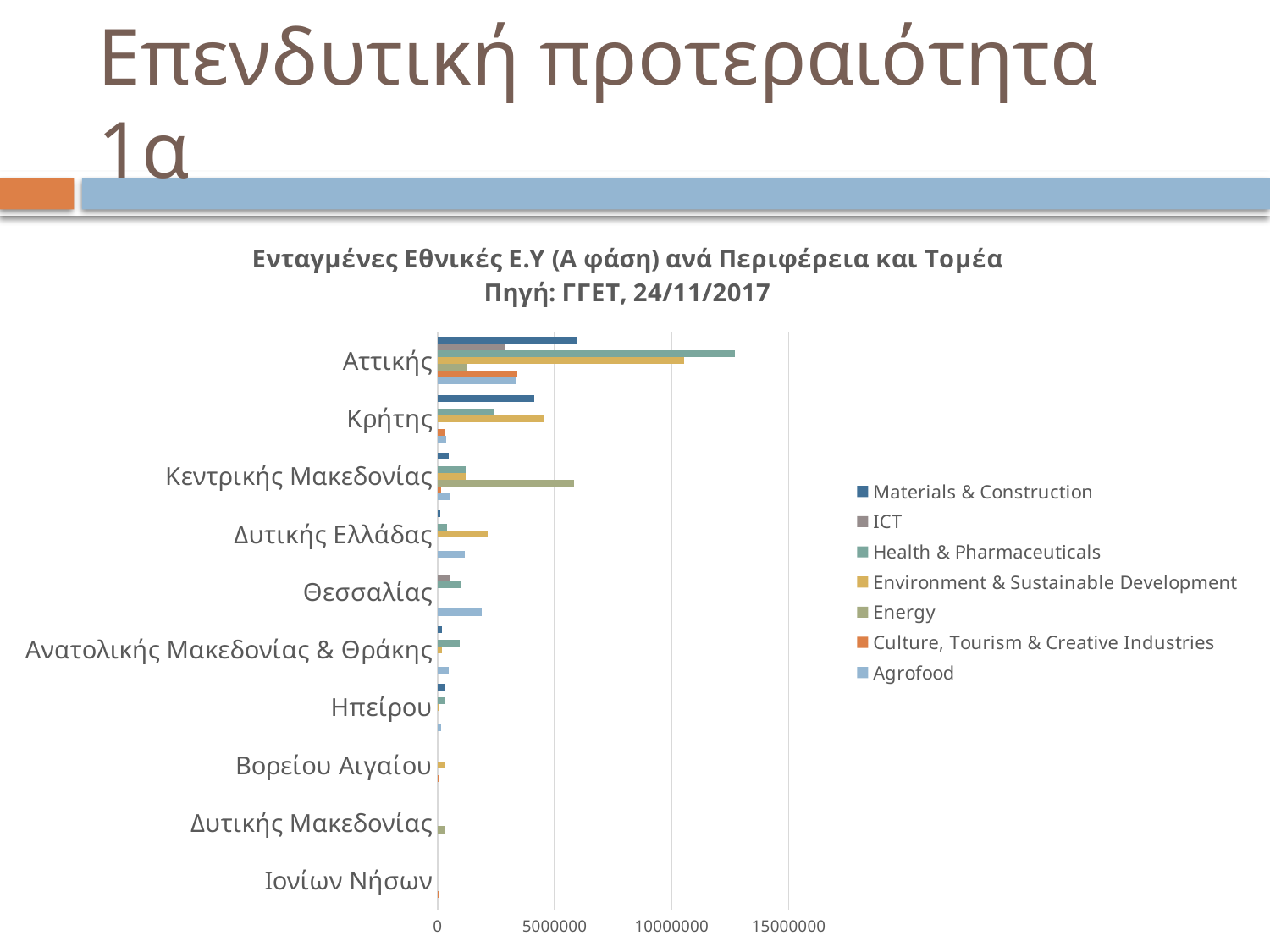
Which region has the smallest bars overall in the chart? Ιονίων Νήσων How many regions (categories) are listed on the vertical axis of the chart? 10 What kind of chart is shown on the slide? bar chart For Κεντρικής Μακεδονίας, which is larger: the Energy value or the Health & Pharmaceuticals value? Energy What is the title of the chart? Ενταγμένες Εθνικές Ε.Υ (Α φάση) ανά Περιφέρεια και Τομέα Πηγή: ΓΓΕΤ, 24/11/2017 How many series does the chart legend list? 7 Is the ICT value for Αττικής greater or less than 5000000? less Is the Agrofood value for Θεσσαλίας greater or less than 5000000? less For Κρήτης, which is larger: the Environment & Sustainable Development value or the Health & Pharmaceuticals value? Environment & Sustainable Development Is the Health & Pharmaceuticals value for Αττικής greater or less than 10000000? greater Which series has the longest bar for Θεσσαλίας? Agrofood Which region has the longest bar in the chart? Αττικής